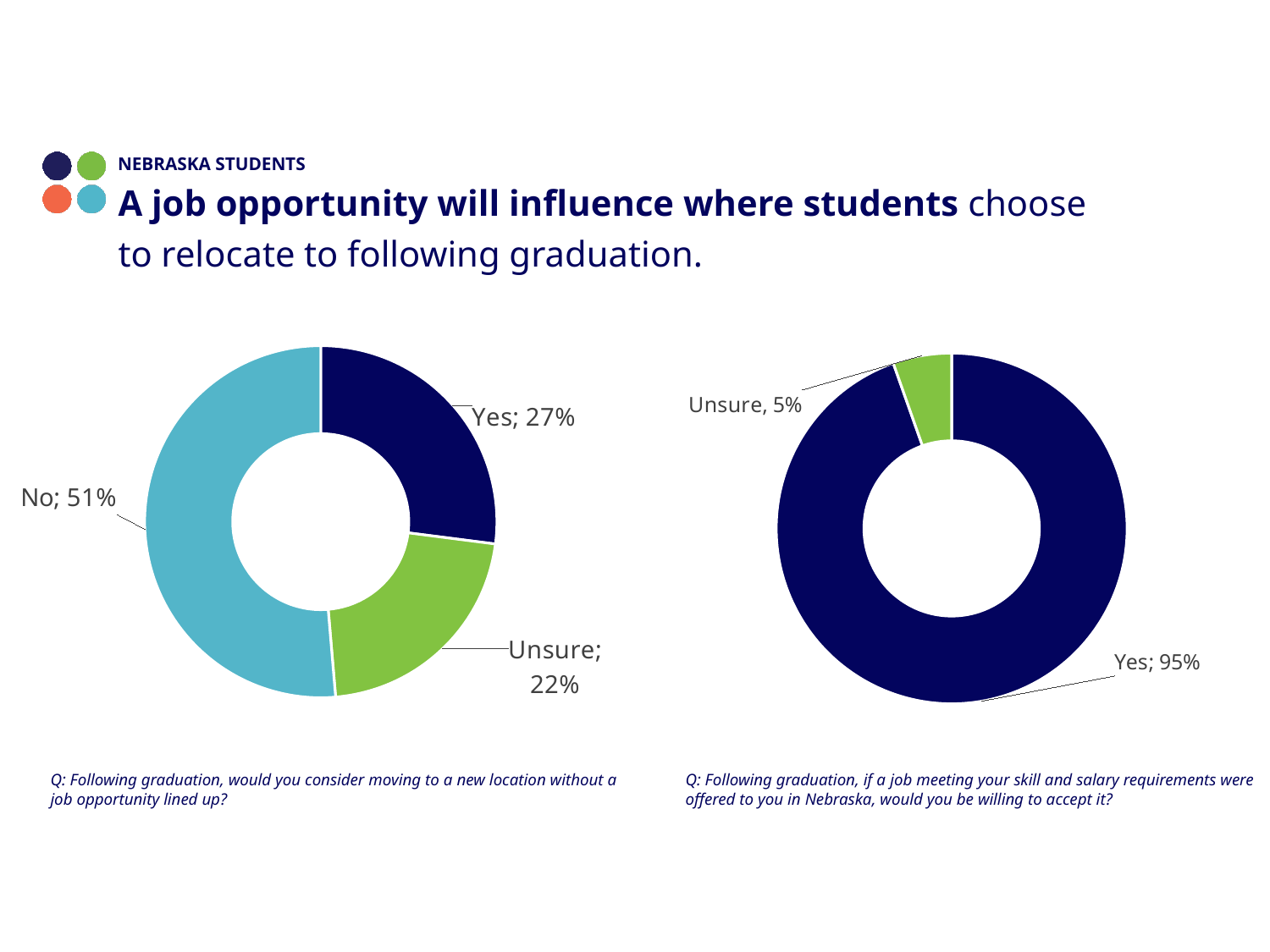
In the left chart, what is the difference between the No and Yes shares? 24% In the left chart, what percentage of students answered Unsure? 22% In the right chart, what is the difference between the Yes and Unsure shares? 90% How many slices does the left chart have? 3 What type of chart is shown on the right? Doughnut chart In the right chart, what percentage of students answered Unsure? 5% In the left chart, which response has the smallest share? Unsure In the left chart, what percentage of students answered Yes? 27% In the left chart, what percentage of students answered No? 51% In the right chart, what percentage of students answered Yes? 95% In the left chart, which is larger, the Yes share or the Unsure share? Yes In the left chart, which response has the largest share? No